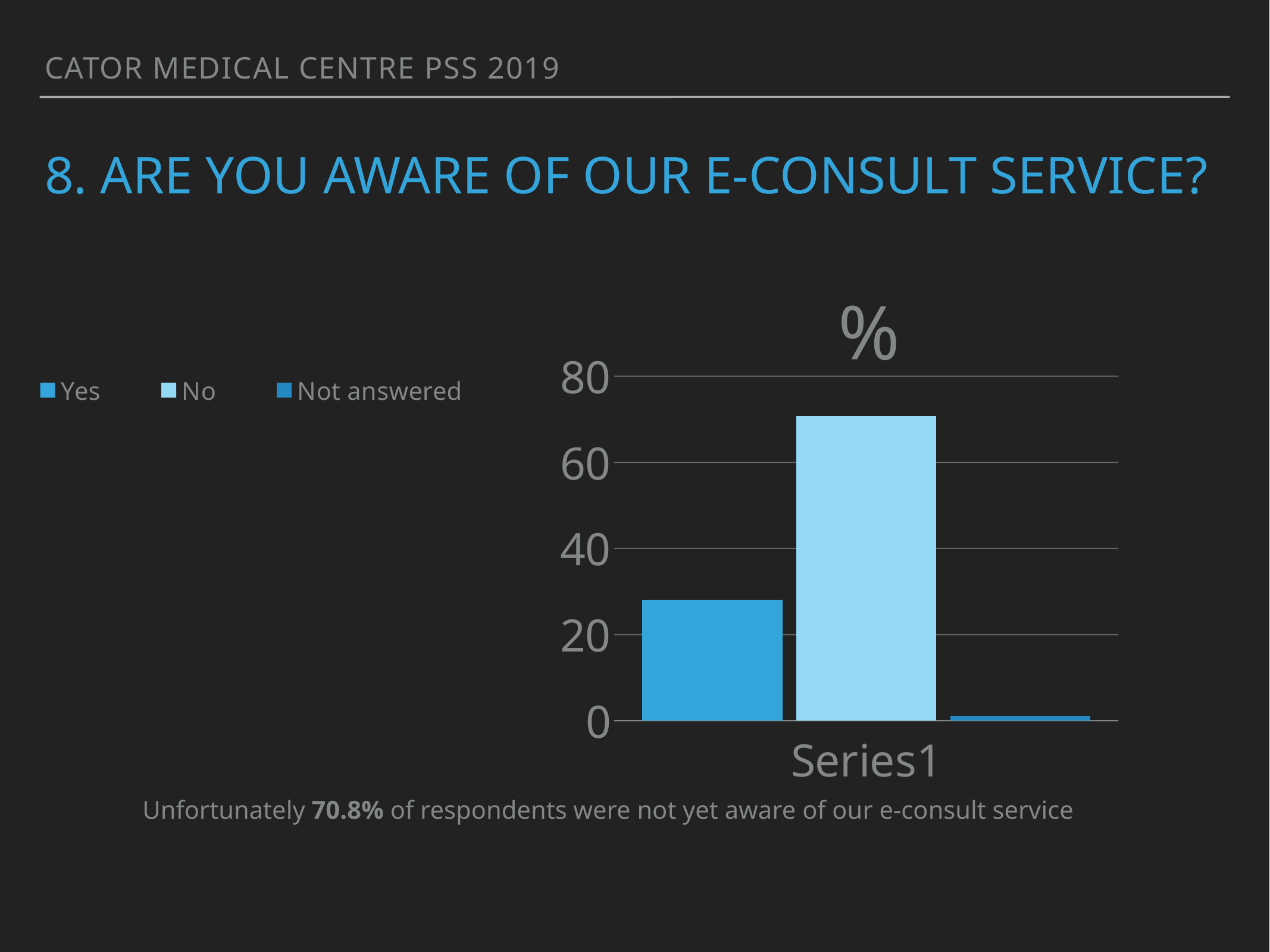
Is the value for Not answered greater or less than 20? less Is the value for No greater or less than 80? less Which is larger, the value for Yes or the value for Not answered? Yes Which series has the highest bar? No How many series does the legend list? 3 Is the value for Yes greater or less than 20? greater Which is larger, the value for Yes or the value for No? No What is the title of the chart? % Which series has the lowest bar? Not answered What kind of chart is shown on the slide? bar chart